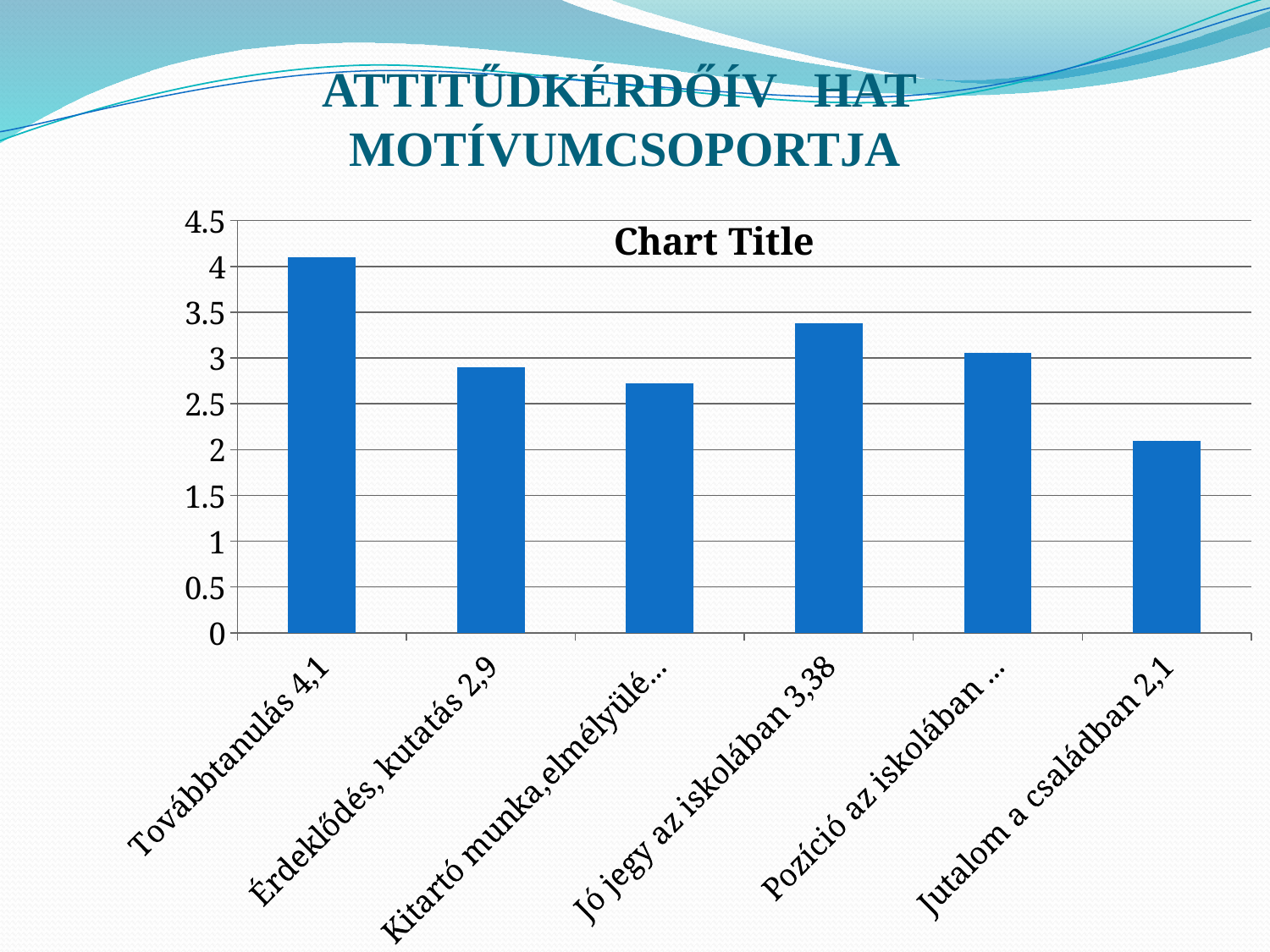
What kind of chart is shown on the slide? bar chart How many categories (bars) does the chart show? 6 Which category has the highest bar? Továbbtanulás What value is shown for Továbbtanulás? 4,1 Is the value for Kitartó munka greater or less than 2.5? greater Is the value for Pozíció az iskolában greater or less than 3.5? less What value is shown for Jó jegy az iskolában? 3,38 Which category has the lowest bar? Jutalom a családban Which is larger, the bar for Jó jegy az iskolában or the bar for Érdeklődés, kutatás? Jó jegy az iskolában What is the difference between the values for Továbbtanulás (4,1) and Jutalom a családban (2,1)? 2 What title is printed inside the chart area? Chart Title What value is shown for Jutalom a családban? 2,1